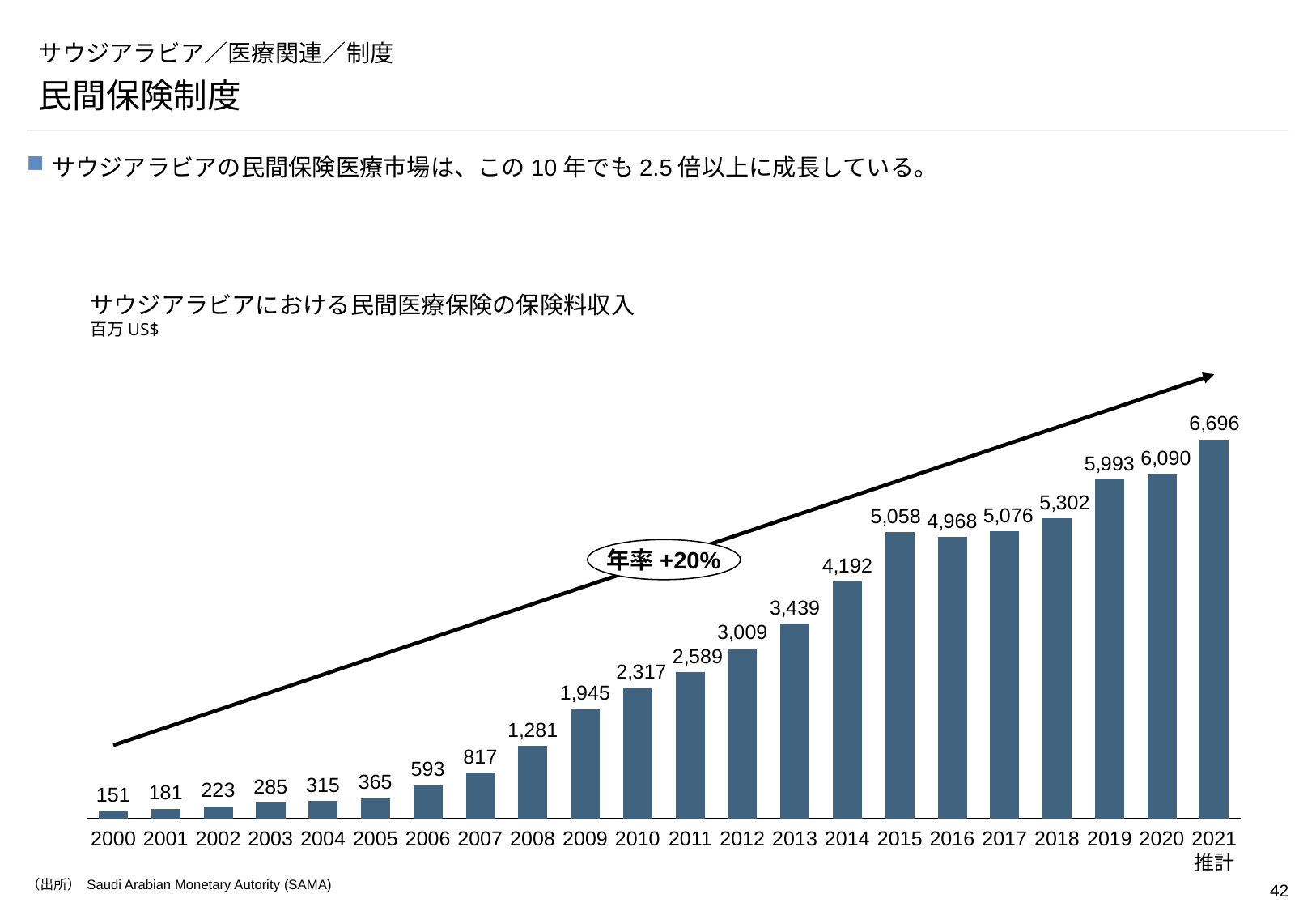
How many years are shown on the x axis? 22 Which year has the highest value? 2021 What type of chart is shown on the slide? Bar chart Which is larger, the value for 2015 or the value for 2016? 2015 What annual growth rate is written in the oval on the chart? 年率 +20% What is the value for 2000? 151 Do the values generally rise or fall from 2000 to 2021? Rise What is the difference between the values for 2016 and 2015? 90 What is the value for 2015? 5,058 Which year has the lowest value? 2000 What is the value for 2010? 2,317 What is the difference between the values for 2021 and 2020? 606